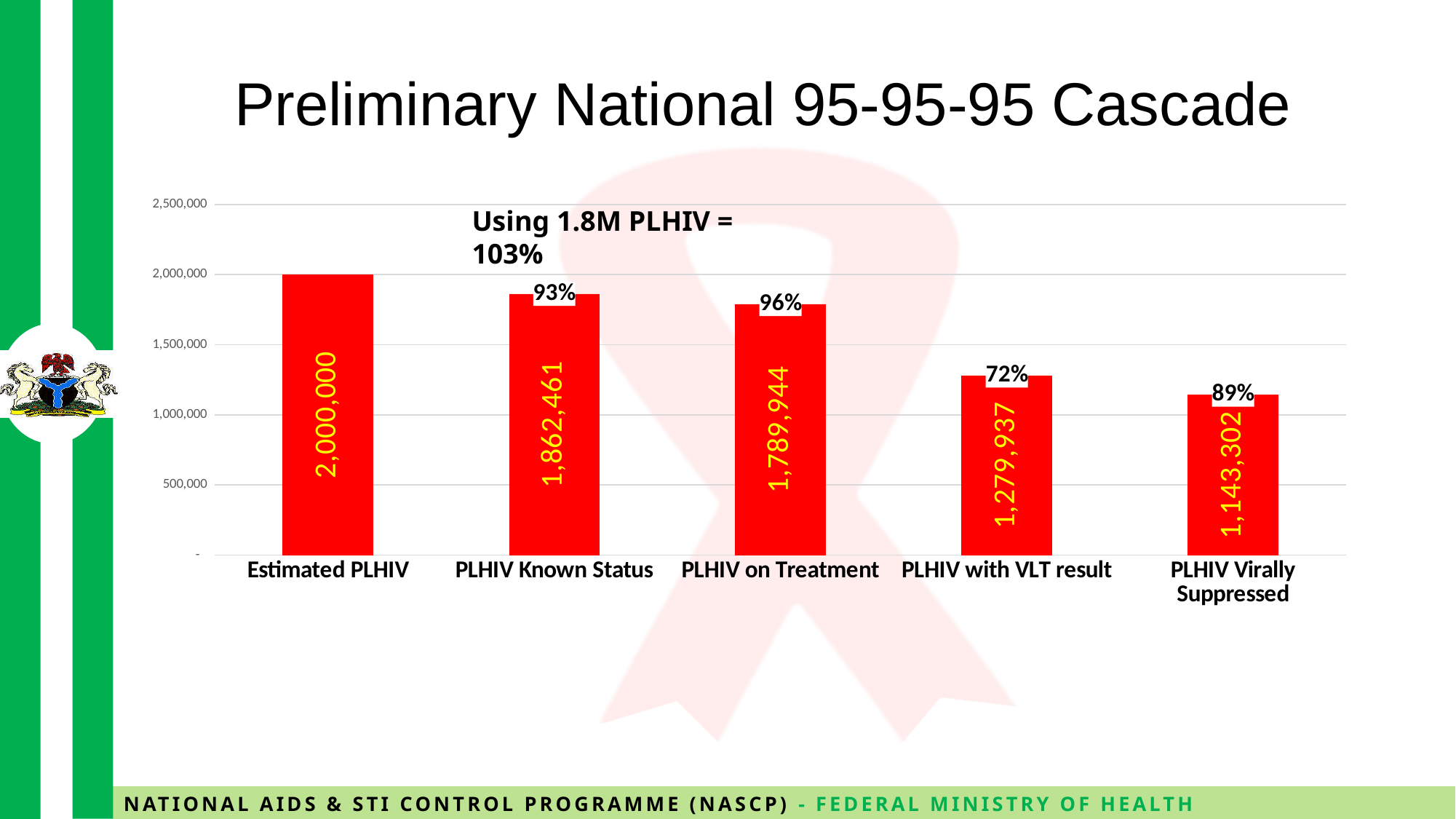
What is the value for PLHIV Known Status? 1,862,461 What is the value for PLHIV Virally Suppressed? 1,143,302 What kind of chart is shown? Bar chart What is the value for Estimated PLHIV? 2,000,000 Which is larger, PLHIV on Treatment or PLHIV with VLT result? PLHIV on Treatment What percentage label is shown above the PLHIV with VLT result bar? 72% Which category has the lowest value? PLHIV Virally Suppressed What is the value for PLHIV with VLT result? 1,279,937 How many categories are shown on the x axis? 5 What is the difference between Estimated PLHIV and PLHIV Known Status? 137,539 Which category has the highest value? Estimated PLHIV What is the value for PLHIV on Treatment? 1,789,944